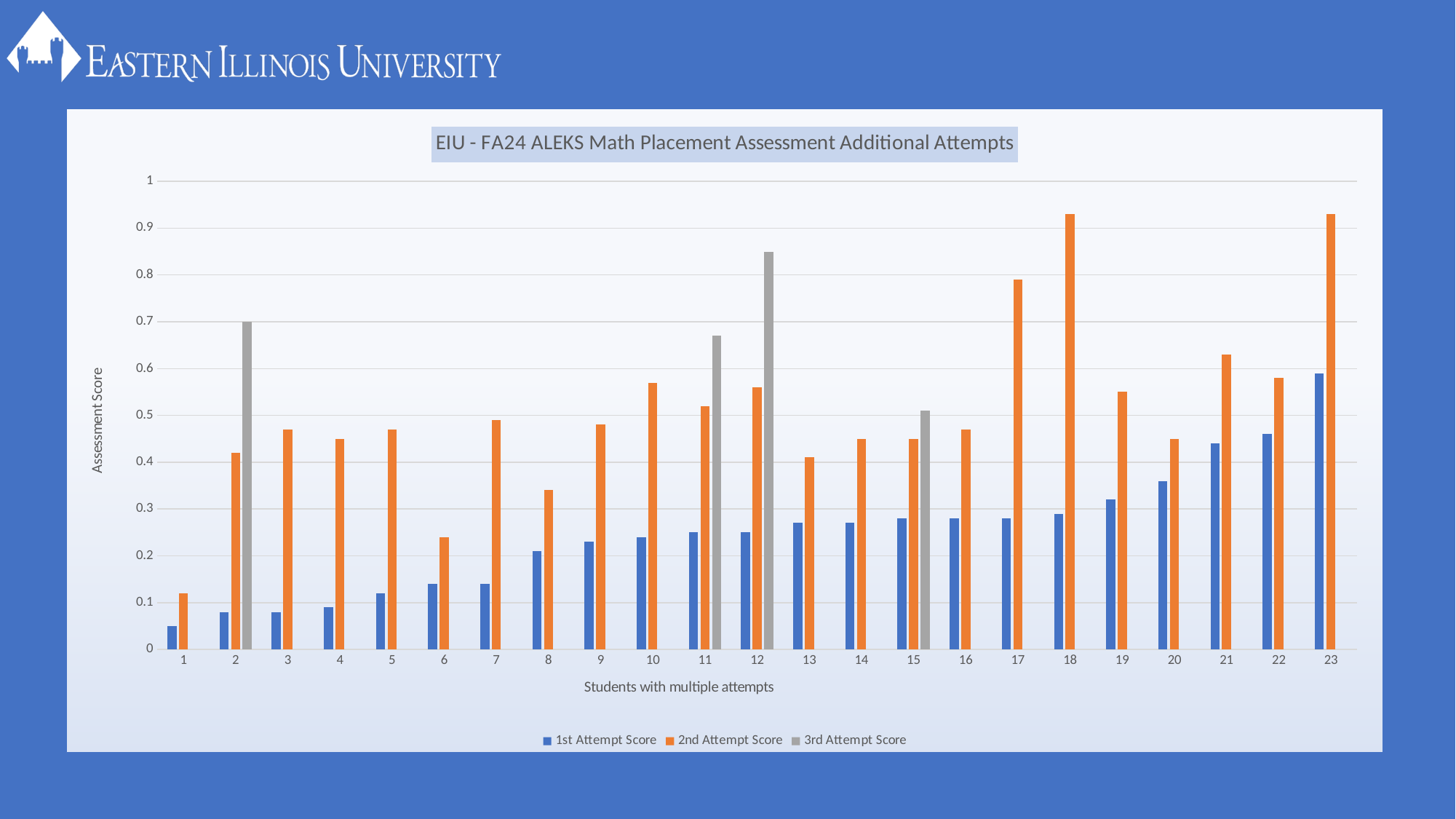
How many students have a 3rd Attempt Score bar? 4 Which student has the highest 3rd Attempt Score? 12 Is the 3rd Attempt Score for student 12 greater or less than 0.8? greater For student 2, which is larger: the 2nd Attempt Score or the 3rd Attempt Score? 3rd Attempt Score How many students are shown along the x axis? 23 Do the 1st Attempt Score values rise or fall from student 1 to student 23? Rise What is the title of the chart? EIU - FA24 ALEKS Math Placement Assessment Additional Attempts Which student has the highest 1st Attempt Score? 23 What kind of chart is shown on the slide? Bar chart Is the 2nd Attempt Score for student 6 greater or less than 0.3? less Which student has the lowest 1st Attempt Score? 1 How many series does the legend list? 3